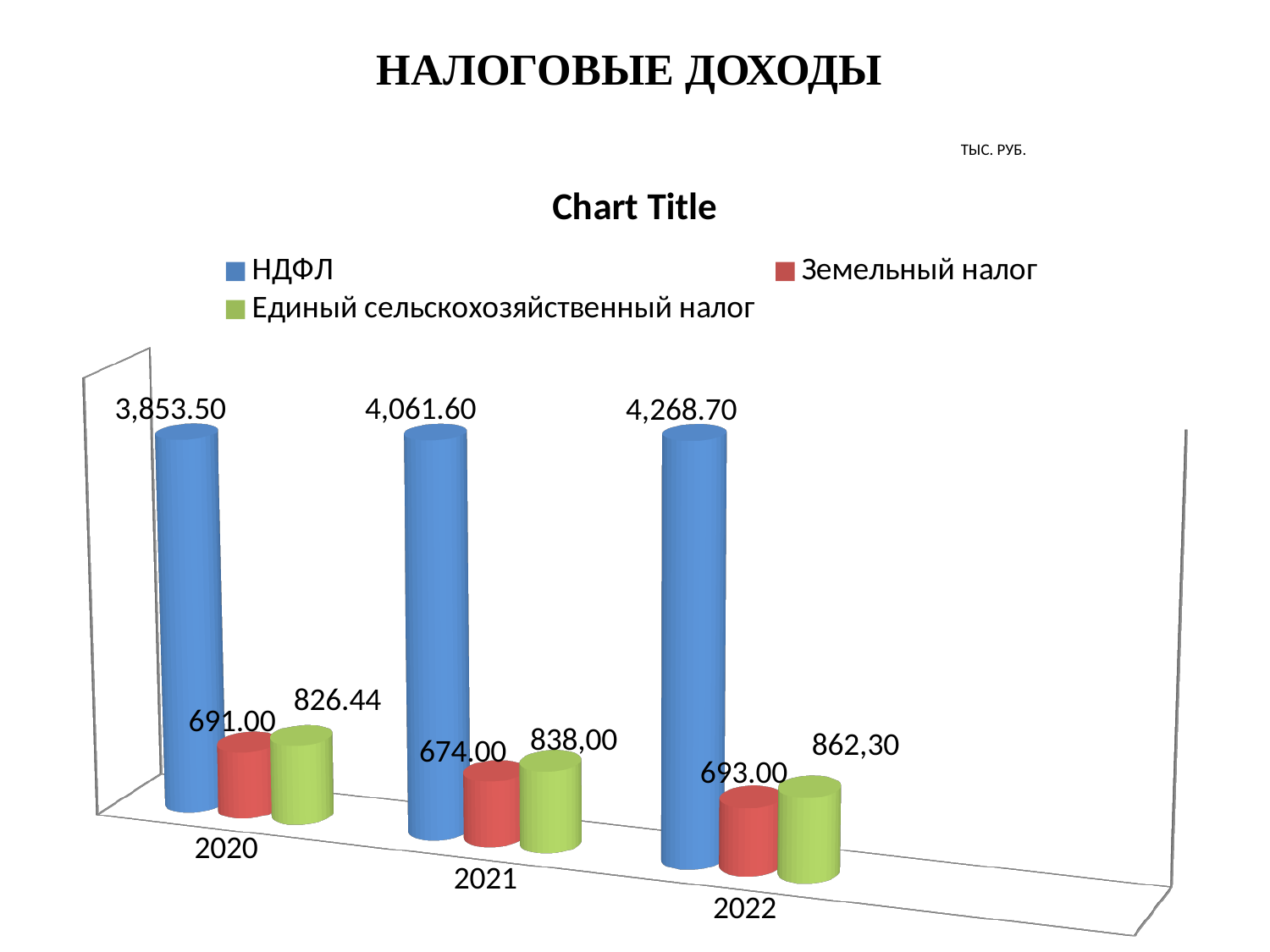
How many series does the legend list? 3 How many years are shown on the x axis? 3 What is the value for НДФЛ in 2022? 4,268.70 What is the value for Земельный налог in 2021? 674.00 What is the value for НДФЛ in 2020? 3,853.50 Which is larger in 2021: Земельный налог or Единый сельскохозяйственный налог? Единый сельскохозяйственный налог What is the value for Единый сельскохозяйственный налог in 2020? 826.44 What is the value for Единый сельскохозяйственный налог in 2022? 862,30 In which year is НДФЛ highest? 2022 What is the difference between the НДФЛ values for 2022 and 2020? 415.20 In which year is Земельный налог lowest? 2021 Does the value for НДФЛ rise or fall from 2020 to 2022? rise